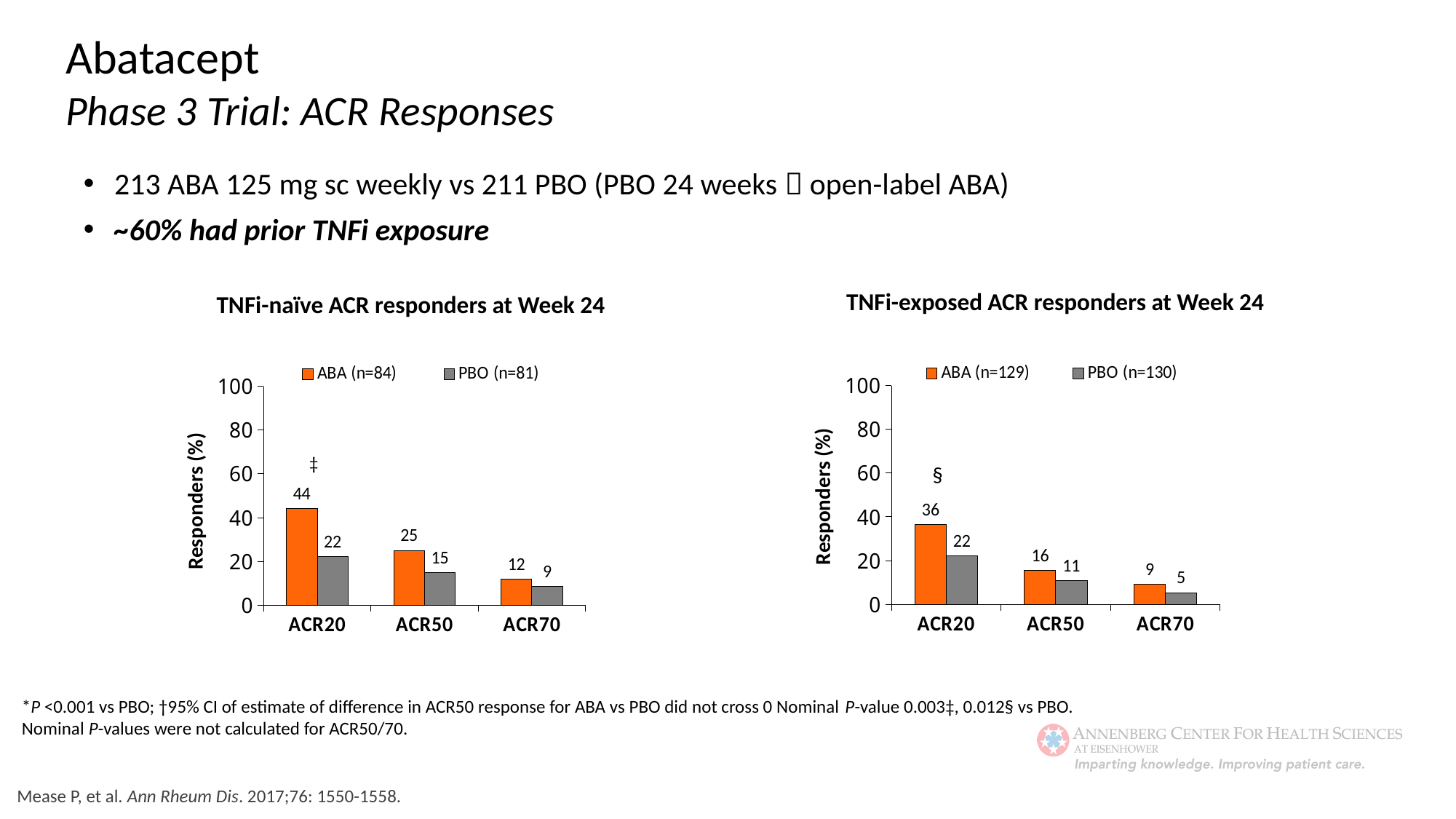
In the 'TNFi-exposed ACR responders at Week 24' chart, what is the difference between ABA and PBO at ACR50? 5 What kind of chart is the 'TNFi-naïve ACR responders at Week 24' chart? Bar chart In the 'TNFi-naïve ACR responders at Week 24' chart, which category has the lowest PBO value? ACR70 In the 'TNFi-naïve ACR responders at Week 24' chart, what is the value for ABA at ACR20? 44 In the 'TNFi-exposed ACR responders at Week 24' chart, what is the value for ABA at ACR70? 9 In the 'TNFi-exposed ACR responders at Week 24' chart, which category has the highest ABA value? ACR20 In the 'TNFi-naïve ACR responders at Week 24' chart, what is the value for PBO at ACR50? 15 How many series does the legend list in the 'TNFi-exposed ACR responders at Week 24' chart? 2 In the 'TNFi-exposed ACR responders at Week 24' chart, do the ABA values rise or fall from ACR20 to ACR70? Fall In the 'TNFi-naïve ACR responders at Week 24' chart, which is larger at ACR50: ABA or PBO? ABA In the 'TNFi-naïve ACR responders at Week 24' chart, what is the difference between ABA and PBO at ACR20? 22 In the 'TNFi-exposed ACR responders at Week 24' chart, what is the value for PBO at ACR20? 22